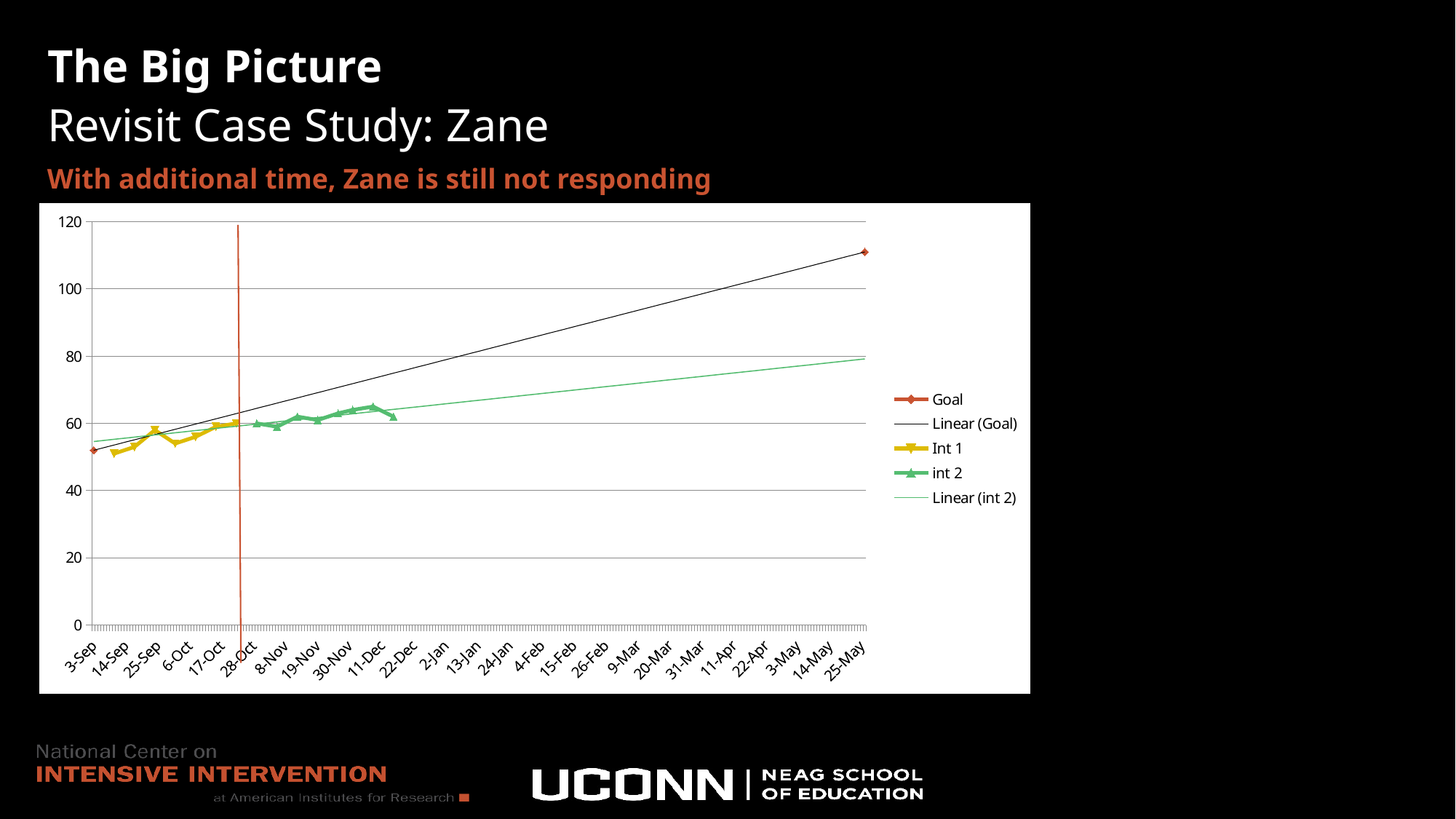
Is the Goal value at 3-Sep greater or less than 60? less At 25-May, which trend line is higher: Linear (Goal) or Linear (int 2)? Linear (Goal) How many series does the legend list? 5 Does the Linear (Goal) line rise or fall from left to right? rise What is the highest value shown on the y axis? 120 How many data points does the Goal series have? 2 What kind of chart is shown on the slide? line chart Which is larger: the Goal value at 3-Sep or the Goal value at 25-May? 25-May What colour is the Int 1 series? yellow Are the int 2 values greater or less than 80? less Is the Goal value at 25-May greater or less than 100? greater